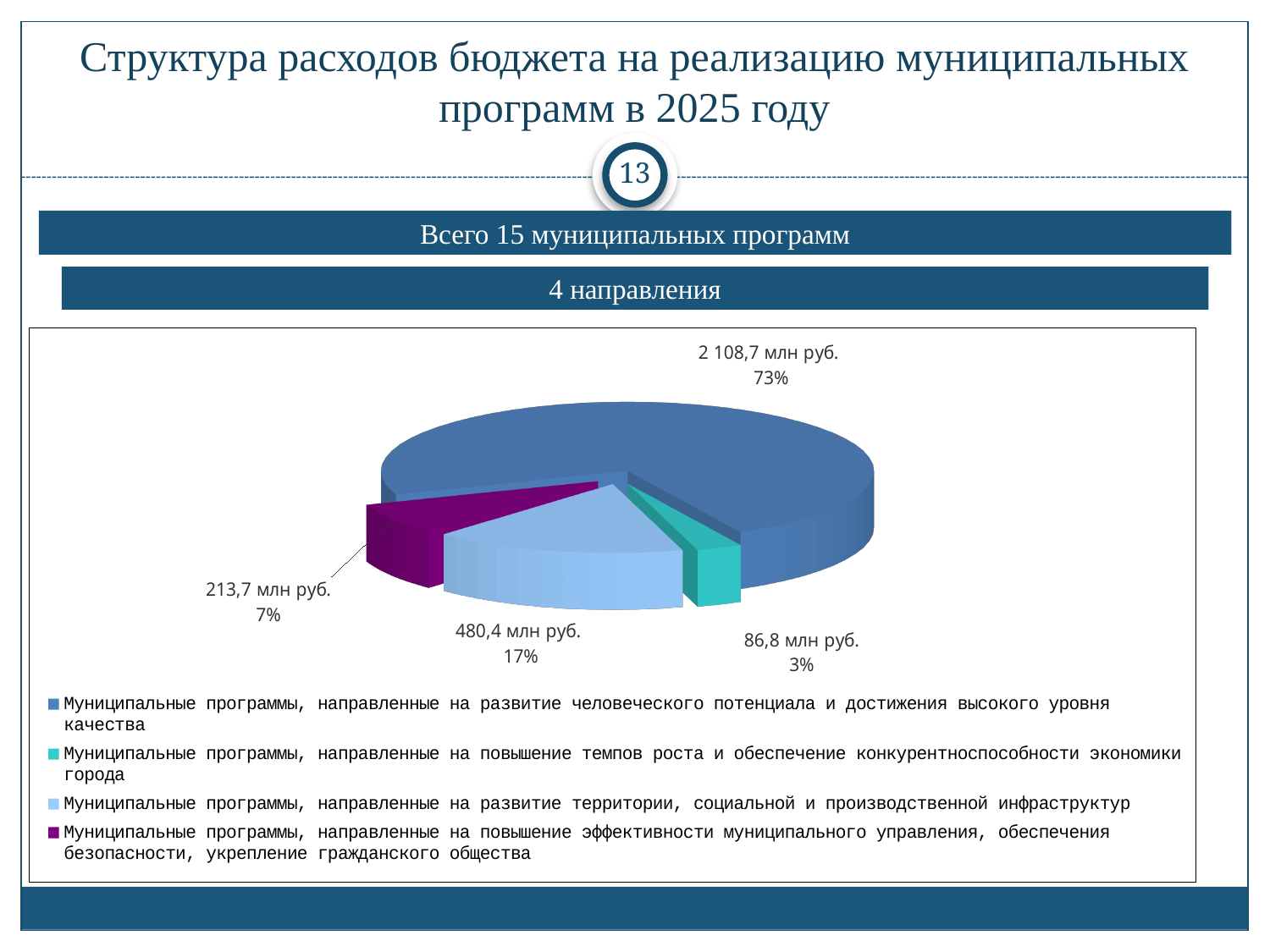
Что больше: расходы на программы повышения эффективности муниципального управления или расходы на программы повышения темпов роста экономики города? Расходы на программы повышения эффективности муниципального управления Каким цветом на диаграмме показан сектор муниципальных программ, направленных на развитие территории, социальной и производственной инфраструктур? Светло-голубым Какая доля расходов приходится на муниципальные программы, направленные на повышение эффективности муниципального управления, обеспечения безопасности, укрепление гражданского общества? 7% Сколько секторов (направлений) показано на круговой диаграмме? 4 Какая сумма расходов приходится на муниципальные программы, направленные на повышение темпов роста и обеспечение конкурентноспособности экономики города? 86,8 млн руб. Какая доля расходов приходится на муниципальные программы, направленные на развитие территории, социальной и производственной инфраструктур? 17% Сколько категорий перечислено в легенде диаграммы? 4 На сколько млн руб. расходы на программы развития территории, социальной и производственной инфраструктур (480,4 млн руб.) больше расходов на программы повышения эффективности муниципального управления (213,7 млн руб.)? 266,7 млн руб. Какое направление имеет наибольшую долю расходов на диаграмме? Муниципальные программы, направленные на развитие человеческого потенциала и достижения высокого уровня качества Какая сумма расходов приходится на муниципальные программы, направленные на развитие человеческого потенциала и достижения высокого уровня качества? 2 108,7 млн руб. Какой тип диаграммы показан на слайде? Круговая диаграмма Какое направление имеет наименьшую долю расходов на диаграмме? Муниципальные программы, направленные на повышение темпов роста и обеспечение конкурентноспособности экономики города